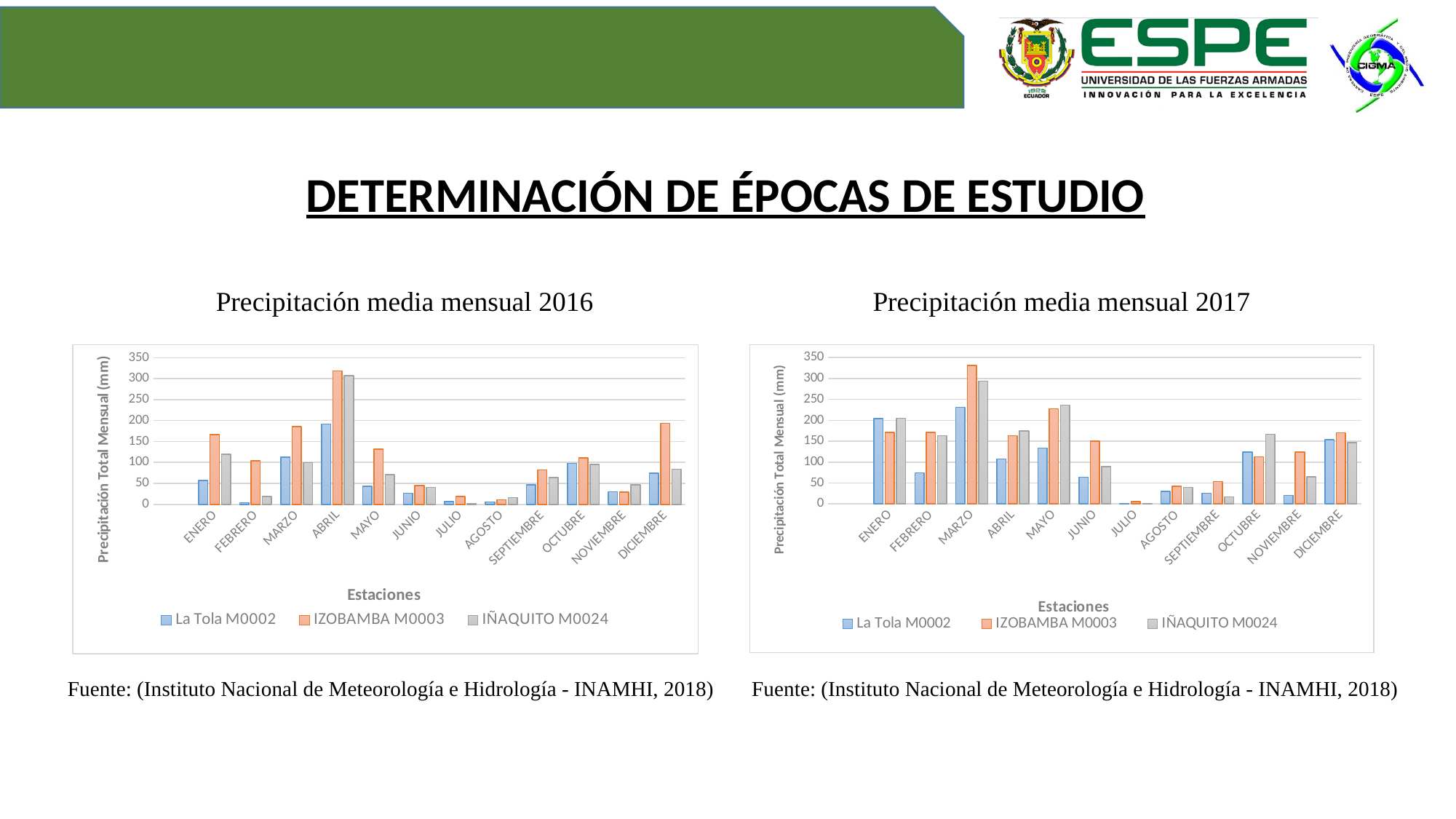
In the 'Precipitación media mensual 2017' chart, in which month is the IZOBAMBA M0003 bar highest? MARZO What type of chart is the 'Precipitación media mensual 2016' chart? bar chart How many series does the legend of the 'Precipitación media mensual 2017' chart list? 3 What is the y-axis title of the 'Precipitación media mensual 2017' chart? Precipitación Total Mensual (mm) In the 'Precipitación media mensual 2017' chart, is the value for IZOBAMBA M0003 in MARZO greater or less than 300? greater In the 'Precipitación media mensual 2016' chart, is the value for IZOBAMBA M0003 in ABRIL greater or less than 300? greater In the 'Precipitación media mensual 2017' chart, is the value for La Tola M0002 in ENERO greater or less than 150? greater In the 'Precipitación media mensual 2016' chart, which is larger in ABRIL: La Tola M0002 or IZOBAMBA M0003? IZOBAMBA M0003 In the 'Precipitación media mensual 2017' chart, which is larger in MAYO: La Tola M0002 or IÑAQUITO M0024? IÑAQUITO M0024 How many months are shown on the x axis of the 'Precipitación media mensual 2016' chart? 12 In the 'Precipitación media mensual 2016' chart, in which month is the IZOBAMBA M0003 bar highest? ABRIL